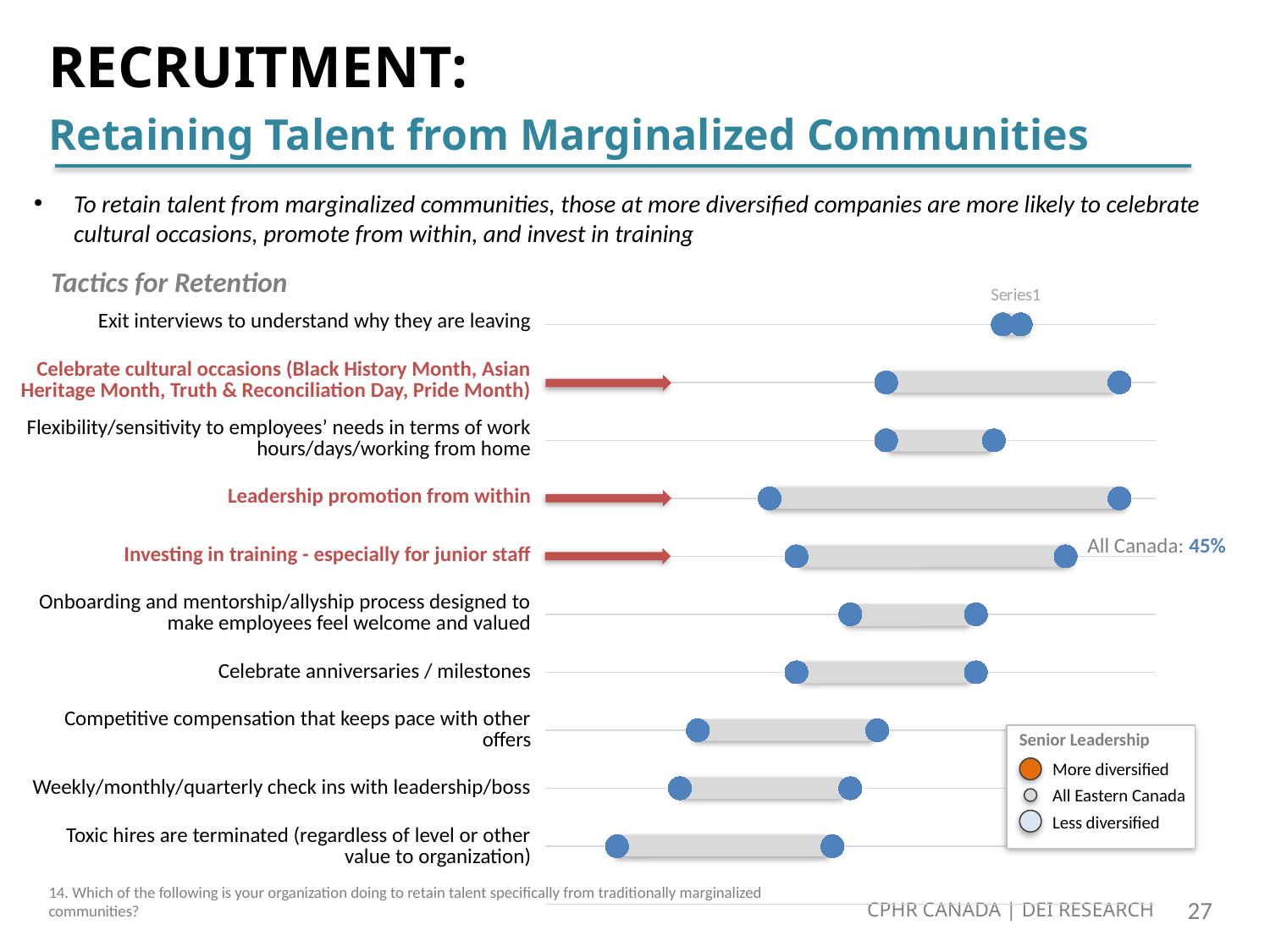
Which tactic's points are positioned furthest to the left on the chart? Toxic hires are terminated (regardless of level or other value to organization) What is the title of the chart on the slide? Tactics for Retention How many retention tactics (categories) are listed on the chart? 10 What All Canada value is annotated next to the 'Investing in training - especially for junior staff' row? 45% What series name appears in the chart legend at the top of the chart? Series1 Which retention tactic shows the widest gap between its two plotted points? Leadership promotion from within Is the gap between the two points for 'Celebrate cultural occasions' larger or smaller than the gap for 'Flexibility/sensitivity to employees' needs'? Larger Which retention tactic shows the narrowest gap between its two plotted points? Exit interviews to understand why they are leaving What kind of chart is shown on the slide? Dot plot (dumbbell chart) Which tactic is listed first (at the top) of the chart? Exit interviews to understand why they are leaving How many retention tactics are marked with a red arrow on the chart? 3